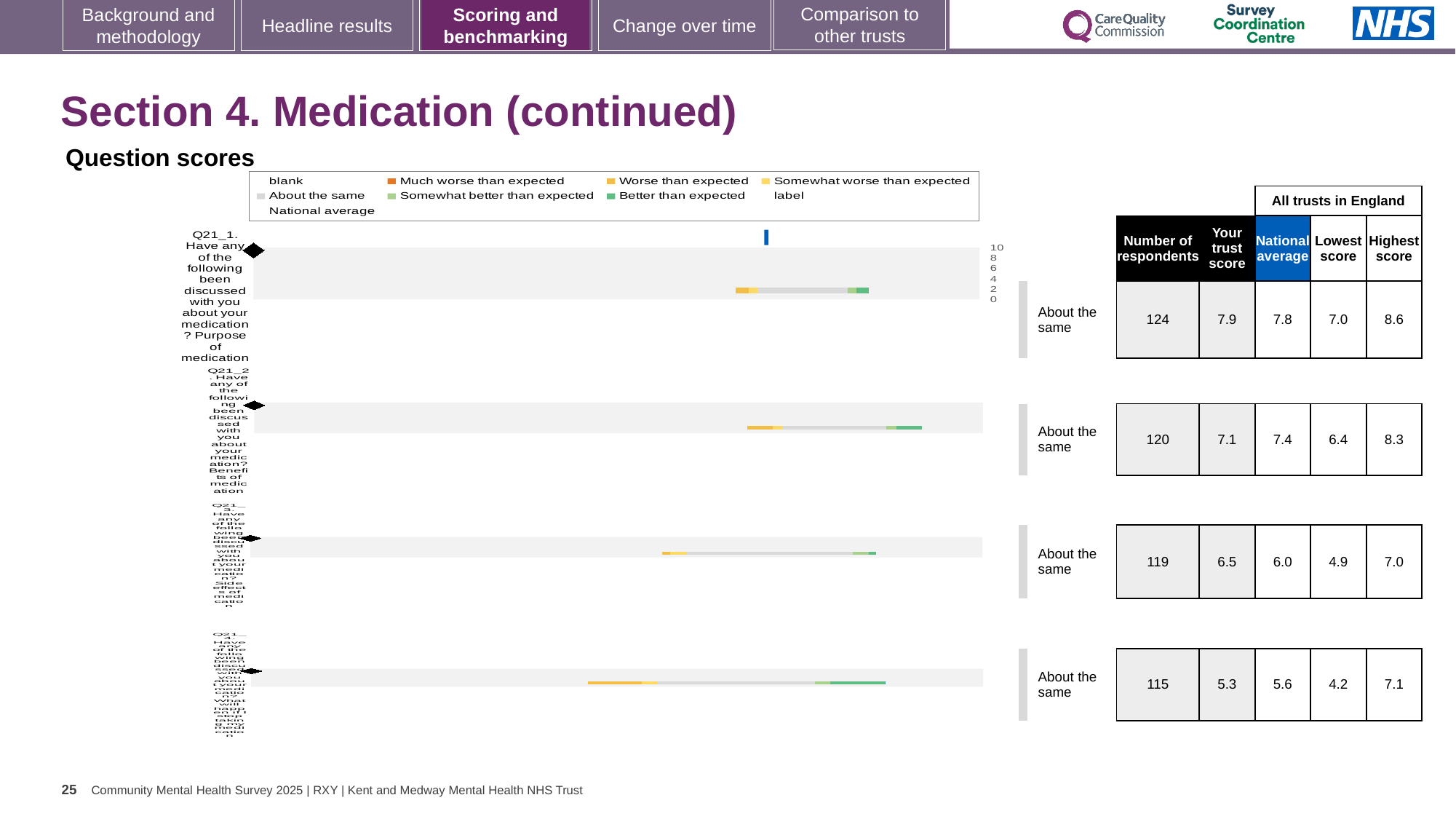
In the table beside the chart, what is the national average for Q21_3 (Side effects of medication)? 6.0 In the table beside the chart, which question has the lowest 'Your trust score'? Q21_4 What colour does the legend use for 'Much worse than expected'? orange How many questions (categories) are plotted in the chart? 4 In the table beside the chart, what is the 'Your trust score' for Q21_1 (Purpose of medication)? 7.9 What benchmark rating is shown next to the bar for Q21_4? About the same What colour does the legend use for 'About the same'? grey What kind of chart is shown under 'Question scores'? bar chart What benchmark rating is shown next to the bar for Q21_1 (Purpose of medication)? About the same In the table beside the chart, for Q21_2 (Benefits of medication), which is larger: the trust score or the national average? National average In the table beside the chart, which question has the highest number of respondents? Q21_1 How many entries does the chart legend list? 9